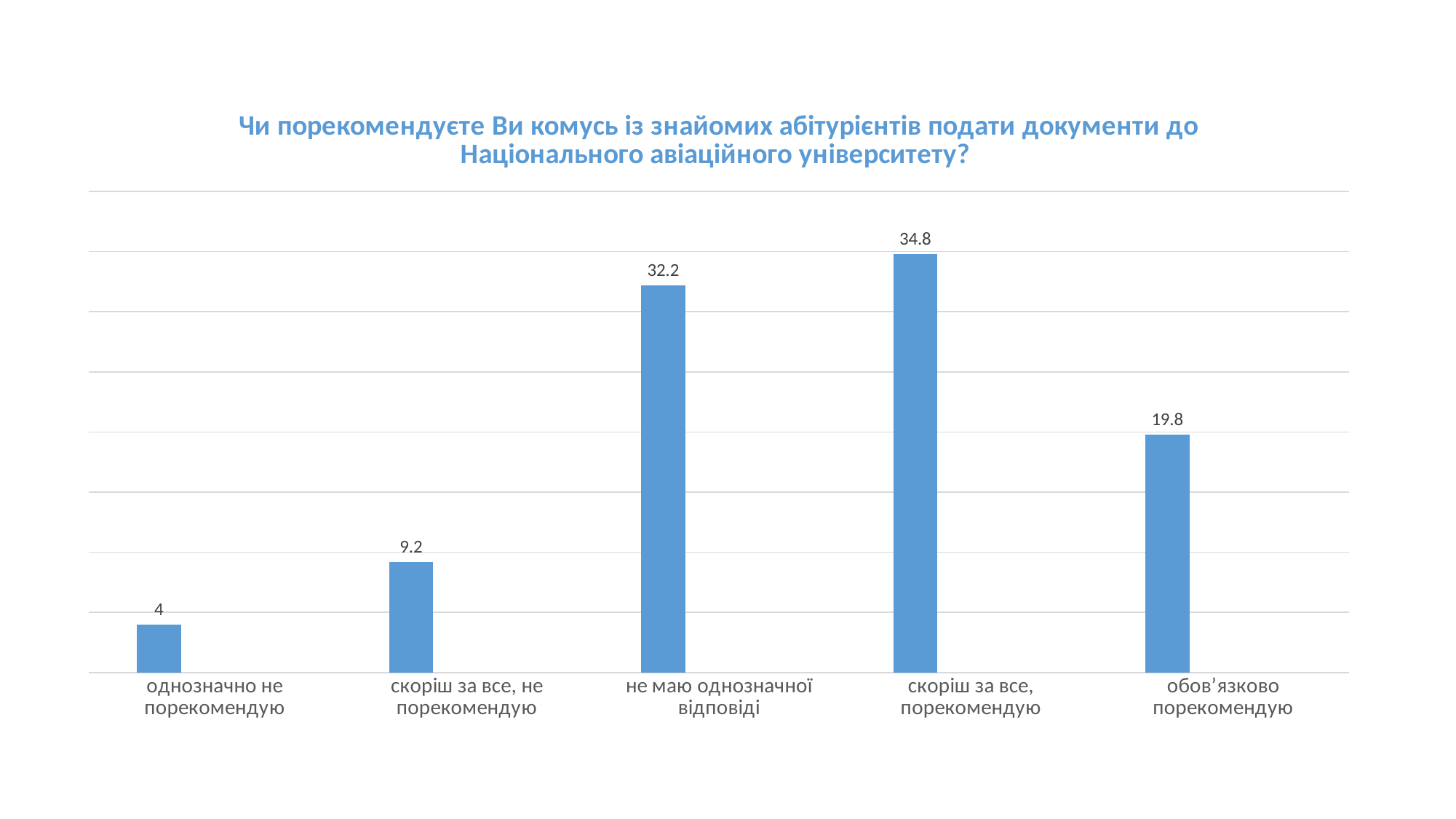
What is the value for "однозначно не порекомендую"? 4 Which category has the highest value? скоріш за все, порекомендую What is the value for "не маю однозначної відповіді"? 32.2 How many categories are shown on the x axis? 5 What kind of chart is shown on the slide? bar chart Which category has the lowest value? однозначно не порекомендую What is the title of the chart? Чи порекомендуєте Ви комусь із знайомих абітурієнтів подати документи до Національного авіаційного університету? What is the difference between the values for "скоріш за все, порекомендую" and "не маю однозначної відповіді"? 2.6 Which is larger, the value for "обов’язково порекомендую" or the value for "скоріш за все, не порекомендую"? обов’язково порекомендую What is the value for "скоріш за все, не порекомендую"? 9.2 What is the difference between the values for "обов’язково порекомендую" and "скоріш за все, не порекомендую"? 10.6 What is the value for "обов’язково порекомендую"? 19.8